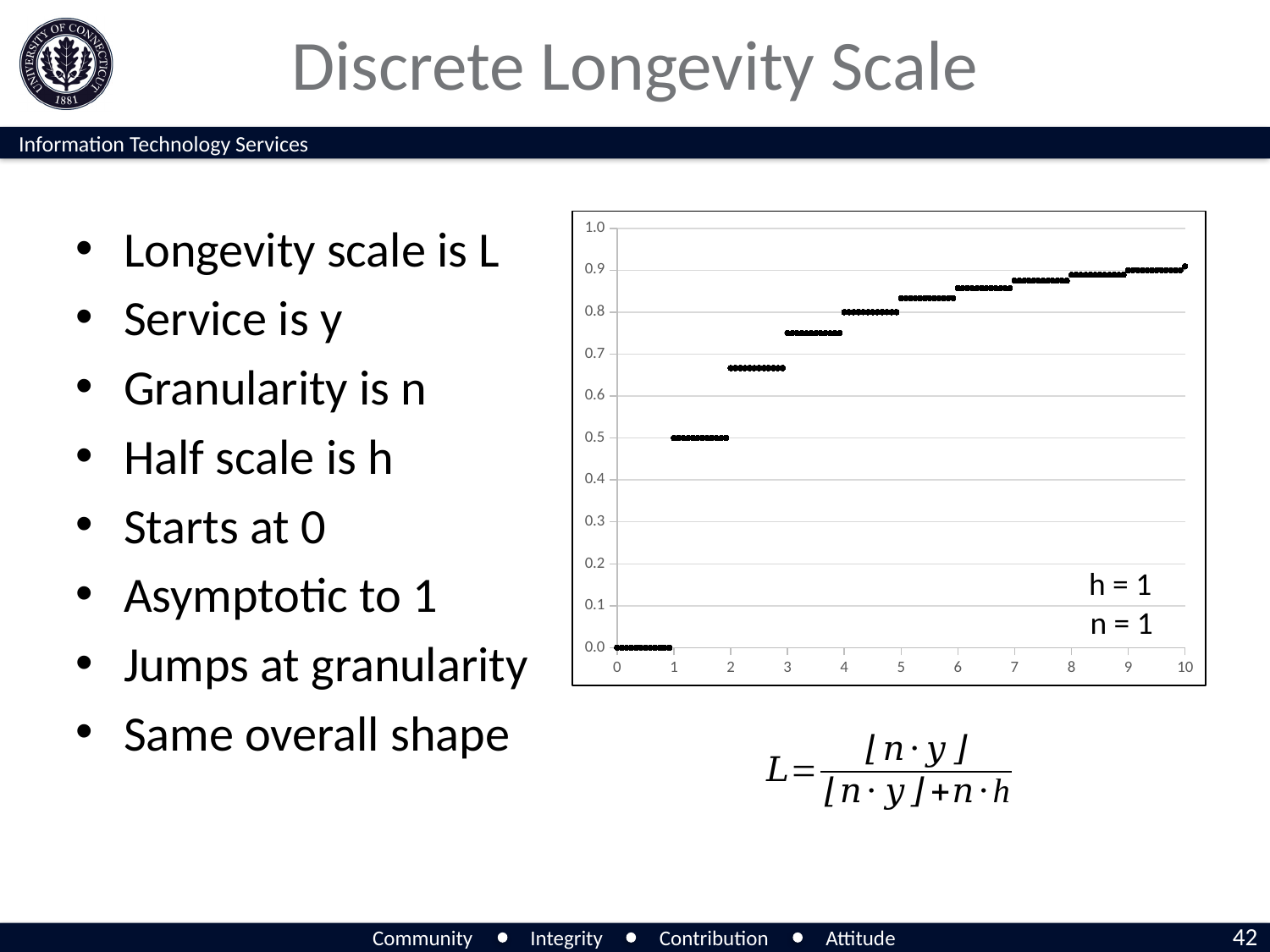
What is the highest value shown on the y axis of the chart? 1.0 Is the plotted value for x between 9 and 10 greater or less than 1.0? less Which is larger, the plotted value for x between 5 and 6 or the value for x between 1 and 2? x between 5 and 6 What is the plotted value for x between 4 and 5? 0.8 What is the highest value shown on the x axis of the chart? 10 What is the plotted value for x between 1 and 2? 0.5 What is the plotted value for x between 0 and 1? 0.0 Do the plotted values rise or fall as the x axis increases from 0 to 10? rise Is the plotted value for x between 3 and 4 greater or less than 0.8? less What kind of chart is shown on the slide? scatter chart What values of h and n are annotated on the chart? h = 1, n = 1 Is the plotted value for x between 2 and 3 greater or less than 0.6? greater